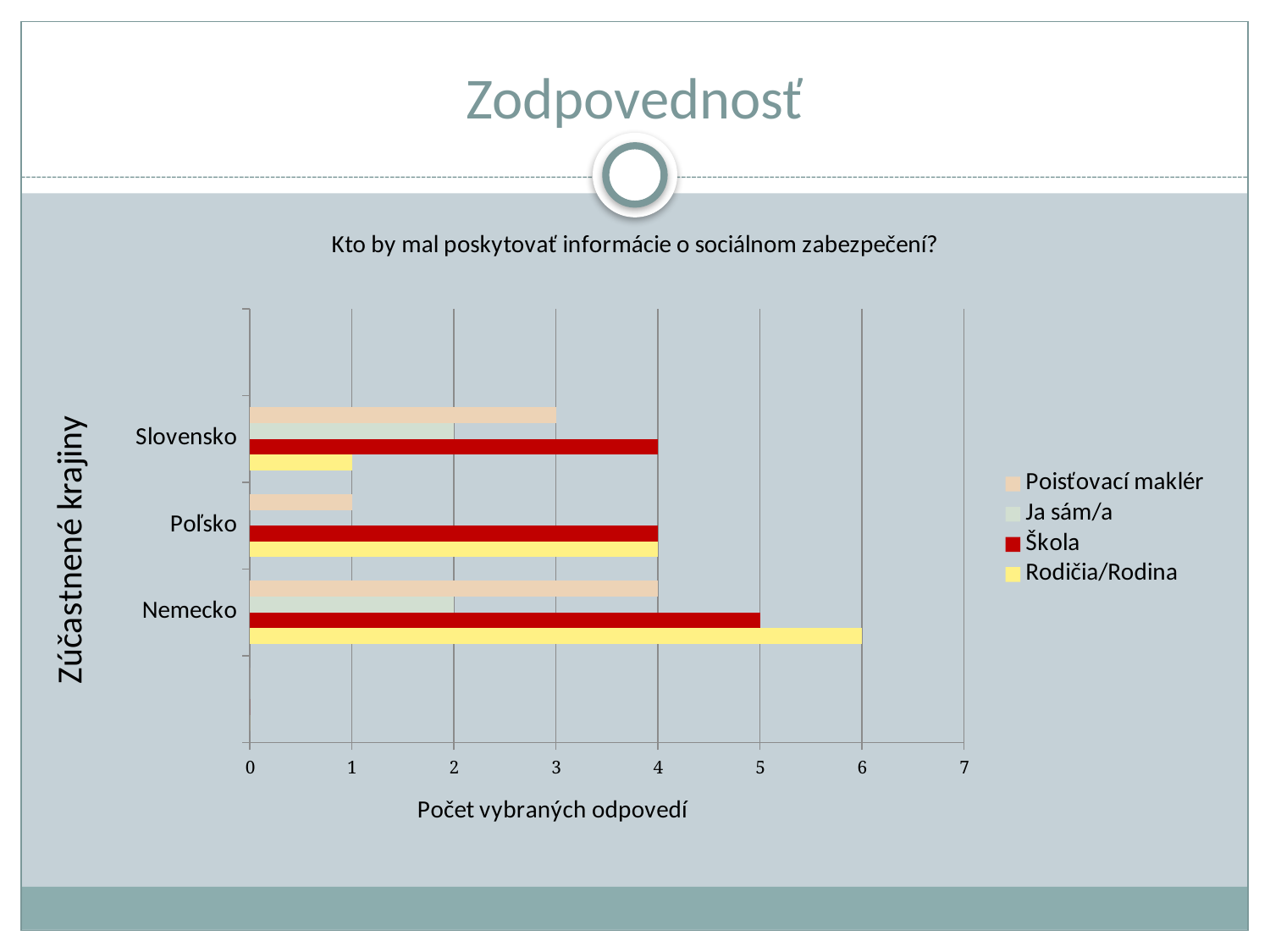
What kind of chart is shown on the slide? bar chart What is the value for Poisťovací maklér for Slovensko? 3 How many countries are shown on the vertical axis? 3 What is the title of the horizontal axis? Počet vybraných odpovedí What is the value for Rodičia/Rodina for Slovensko? 1 How many series does the legend list? 4 What is the difference between the Rodičia/Rodina values for Nemecko and Slovensko? 5 What is the value for Rodičia/Rodina for Nemecko? 6 What is the value for Škola for Nemecko? 5 Which country has the highest value for Rodičia/Rodina? Nemecko Which country has the lowest value for Poisťovací maklér? Poľsko Which is larger for Slovensko: Škola or Ja sám/a? Škola